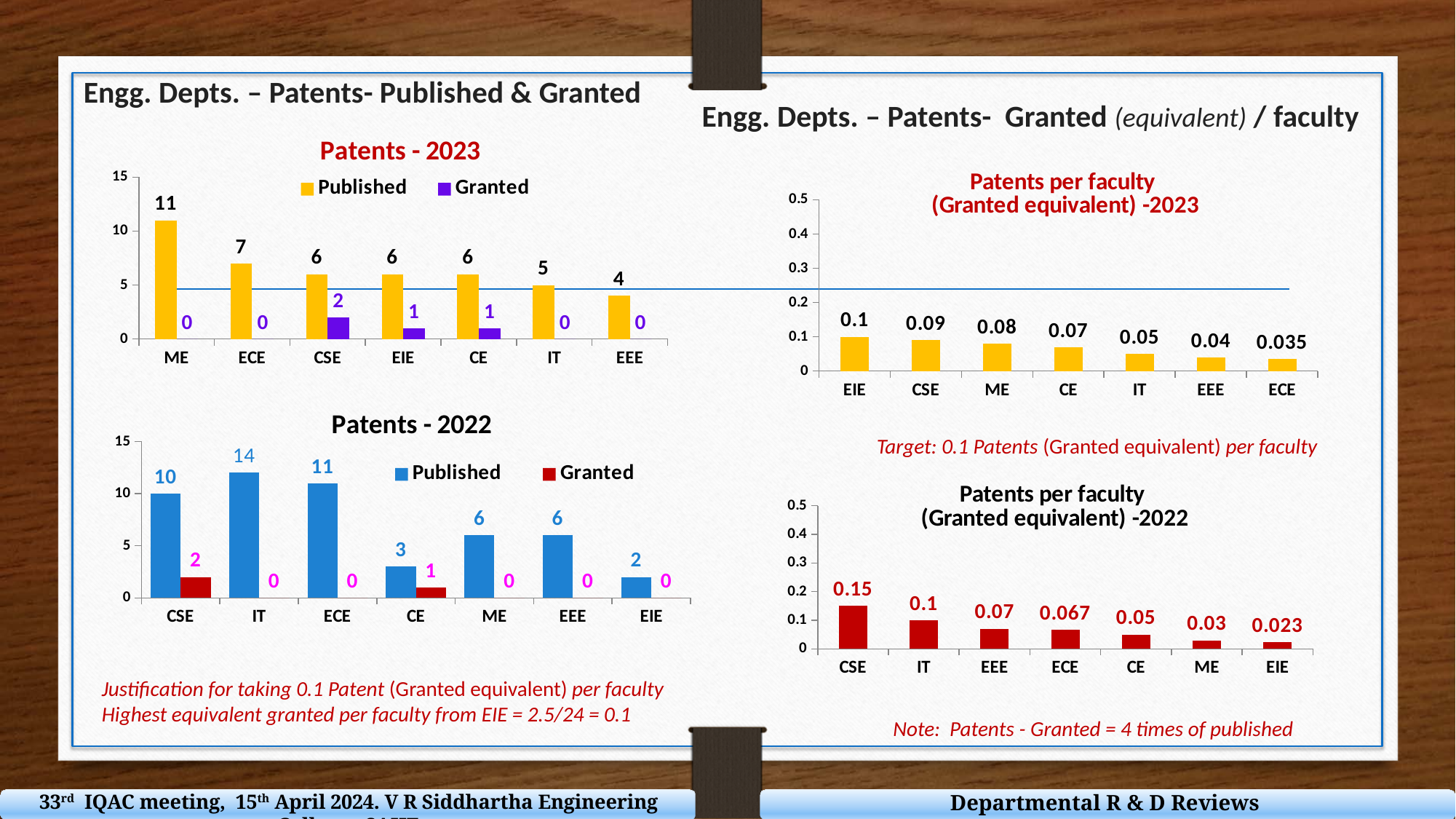
In the 'Patents - 2022' chart, which department has the highest number of published patents? IT In the 'Patents - 2023' chart, which department has the highest number of published patents? ME In the 'Patents per faculty (Granted equivalent) -2023' chart, what is the value for EIE? 0.1 In the 'Patents - 2022' chart, how many patents were granted for CSE? 2 In the 'Patents - 2023' chart, what is the difference between published patents for ME and ECE? 4 How many series does the legend of the 'Patents - 2022' chart list? 2 In the 'Patents per faculty (Granted equivalent) -2023' chart, which department has the lowest value? ECE How many departments are shown in the 'Patents per faculty (Granted equivalent) -2022' chart? 7 In the 'Patents per faculty (Granted equivalent) -2022' chart, what is the value for CSE? 0.15 In the 'Patents - 2022' chart, which is larger: published patents for ECE or for ME? ECE In the 'Patents - 2023' chart, how many patents were published by ME? 11 In the 'Patents - 2023' chart, how many patents were granted for CSE? 2